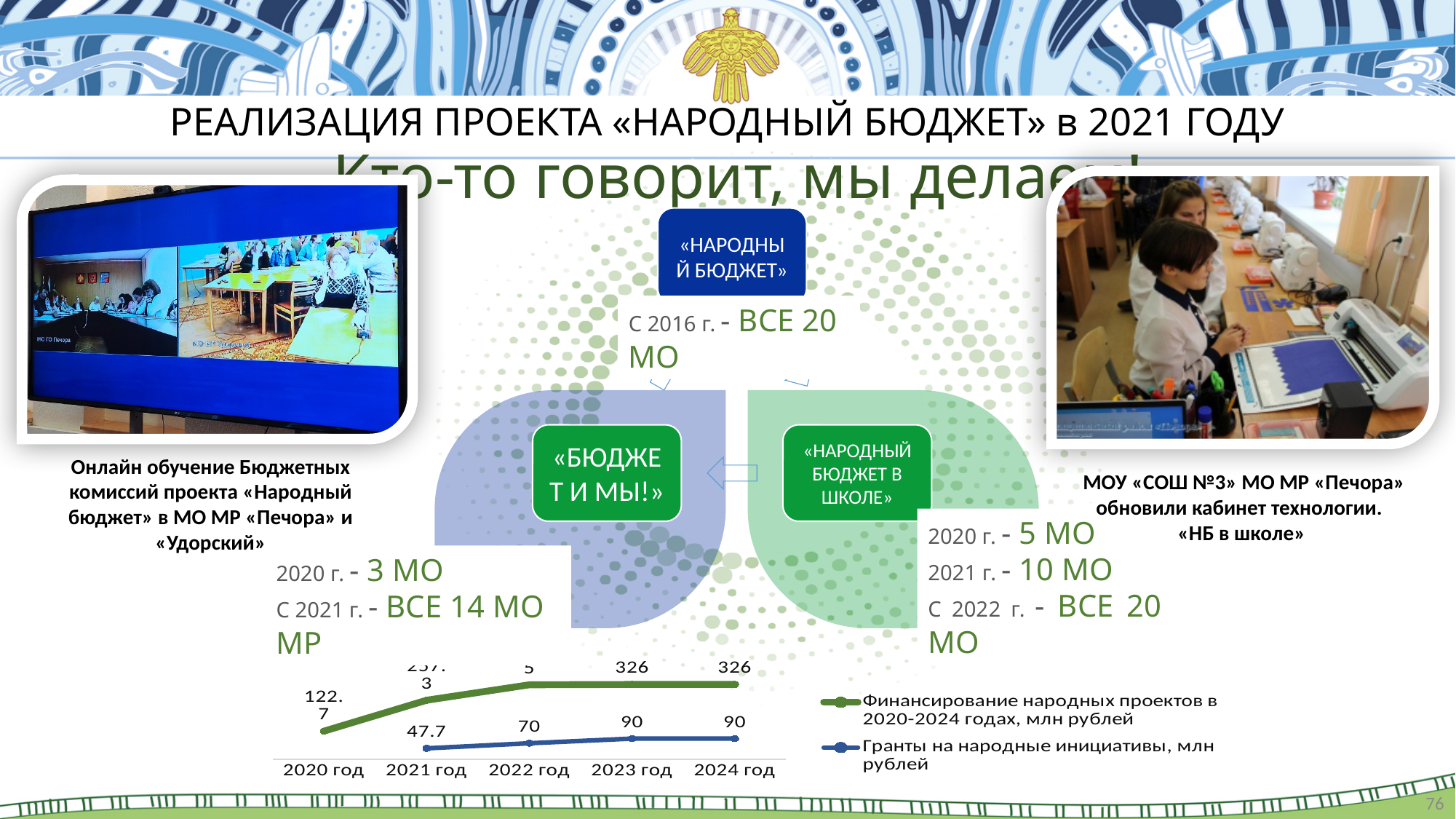
In which year is the value of 'Гранты на народные инициативы' lowest? 2021 год What is the value of 'Гранты на народные инициативы' for 2024 год? 90 What is the value of 'Финансирование народных проектов' for 2023 год? 326 What is the value of 'Финансирование народных проектов' for 2020 год? 122.7 What is the difference between 'Гранты на народные инициативы' in 2023 год and 2022 год? 20 Which series has the larger value in 2023 год: 'Финансирование народных проектов' or 'Гранты на народные инициативы'? Финансирование народных проектов What is the value of 'Гранты на народные инициативы' for 2022 год? 70 What is the value of 'Гранты на народные инициативы' for 2021 год? 47.7 What kind of chart is shown at the bottom of the slide? line chart In which year is the value of 'Финансирование народных проектов' lowest? 2020 год How many years are shown on the x axis of the chart? 5 How many series does the chart legend list? 2